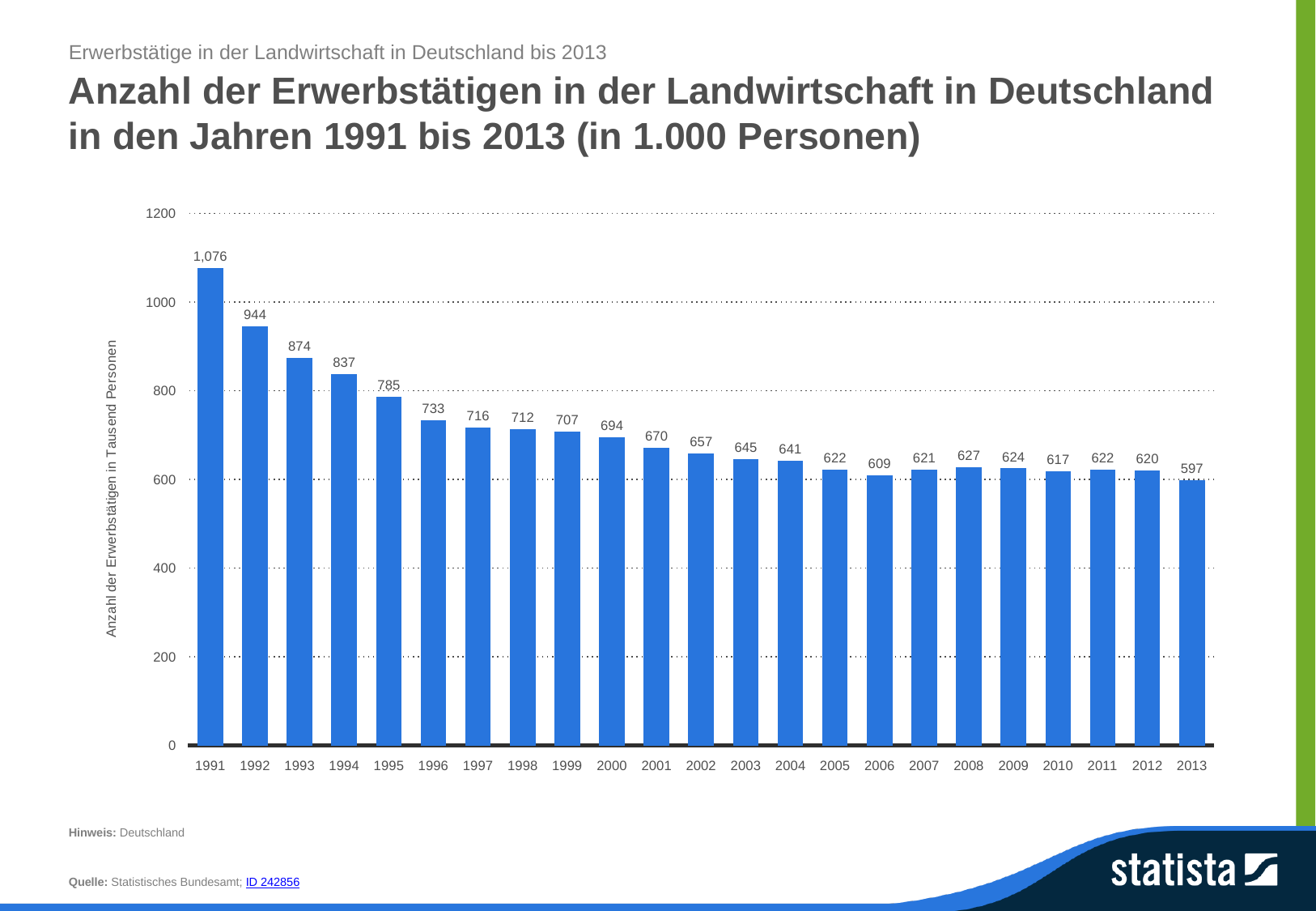
Which is larger, the value for 1995 or the value for 1996? 1995 Which year has the lowest value? 2013 Is the value for 2000 greater or less than 600? greater What kind of chart is shown? bar chart What is the value for 2006? 609 What is the difference between the values for 2005 and 2006? 13 Which year has the highest value? 1991 How many years are shown on the x axis? 23 Do the values generally rise or fall from 1991 to 2013? fall What is the difference between the values for 1991 and 1992? 132 What is the value for 1991? 1,076 What is the value for 2013? 597